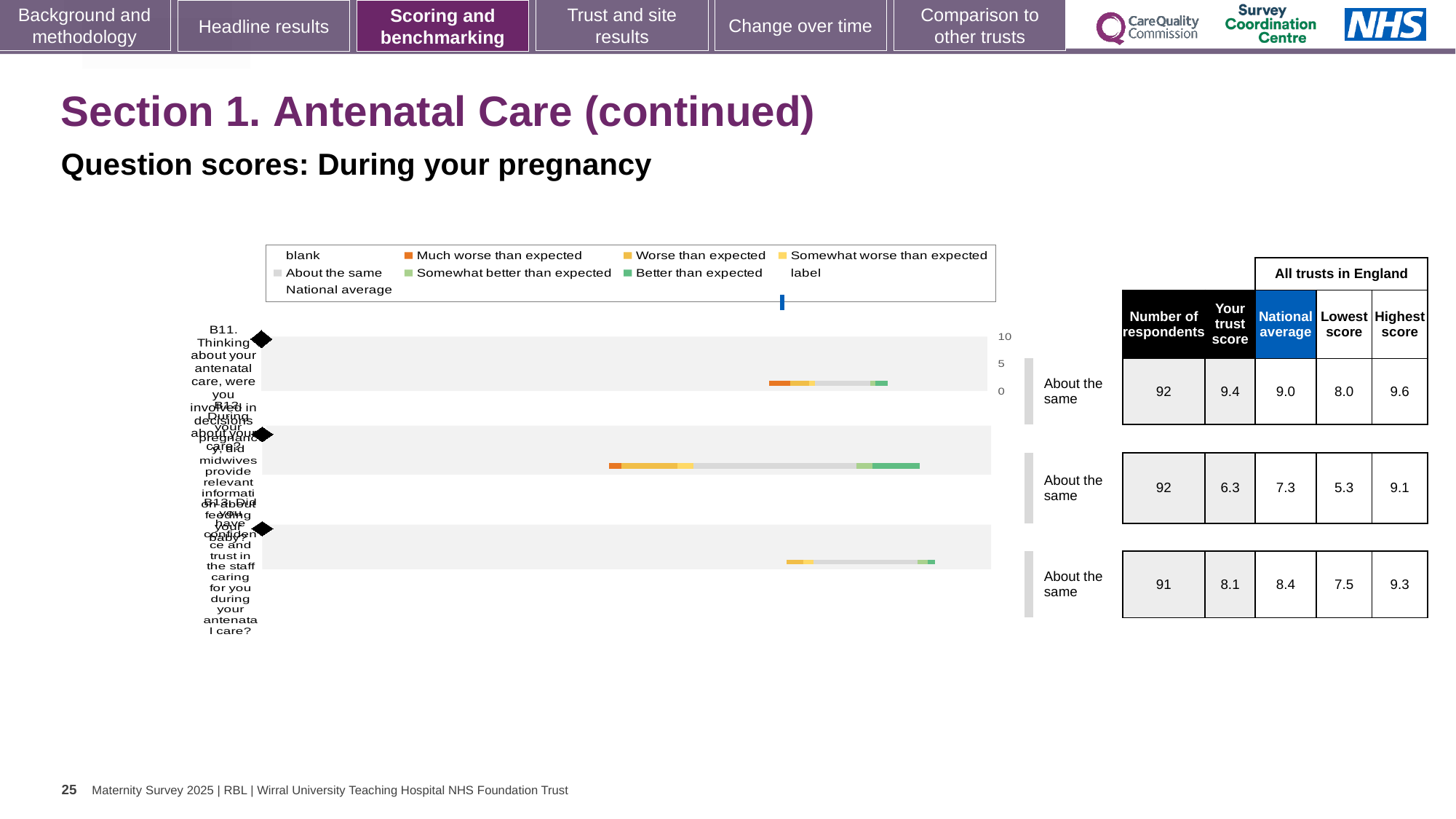
How many entries does the chart legend list? 9 What kind of chart is shown on the slide? bar chart How many questions (categories) are plotted in the chart? 3 In the table beside the chart, what is the difference between the highest score and the lowest score for question B12? 3.8 In the table beside the chart, what is the highest score across all trusts in England for question B13? 9.3 In the table beside the chart, how many respondents are listed for question B13? 91 What benchmark category is shown next to the bar for question B12? About the same For question B11, is the trust score or the national average larger in the table beside the chart? Trust score Which question has the highest trust score in the table beside the chart? B11 In the table beside the chart, what is the national average for question B12? 7.3 Which question has the lowest trust score in the table beside the chart? B12 In the table beside the chart, what is the trust score for question B11? 9.4